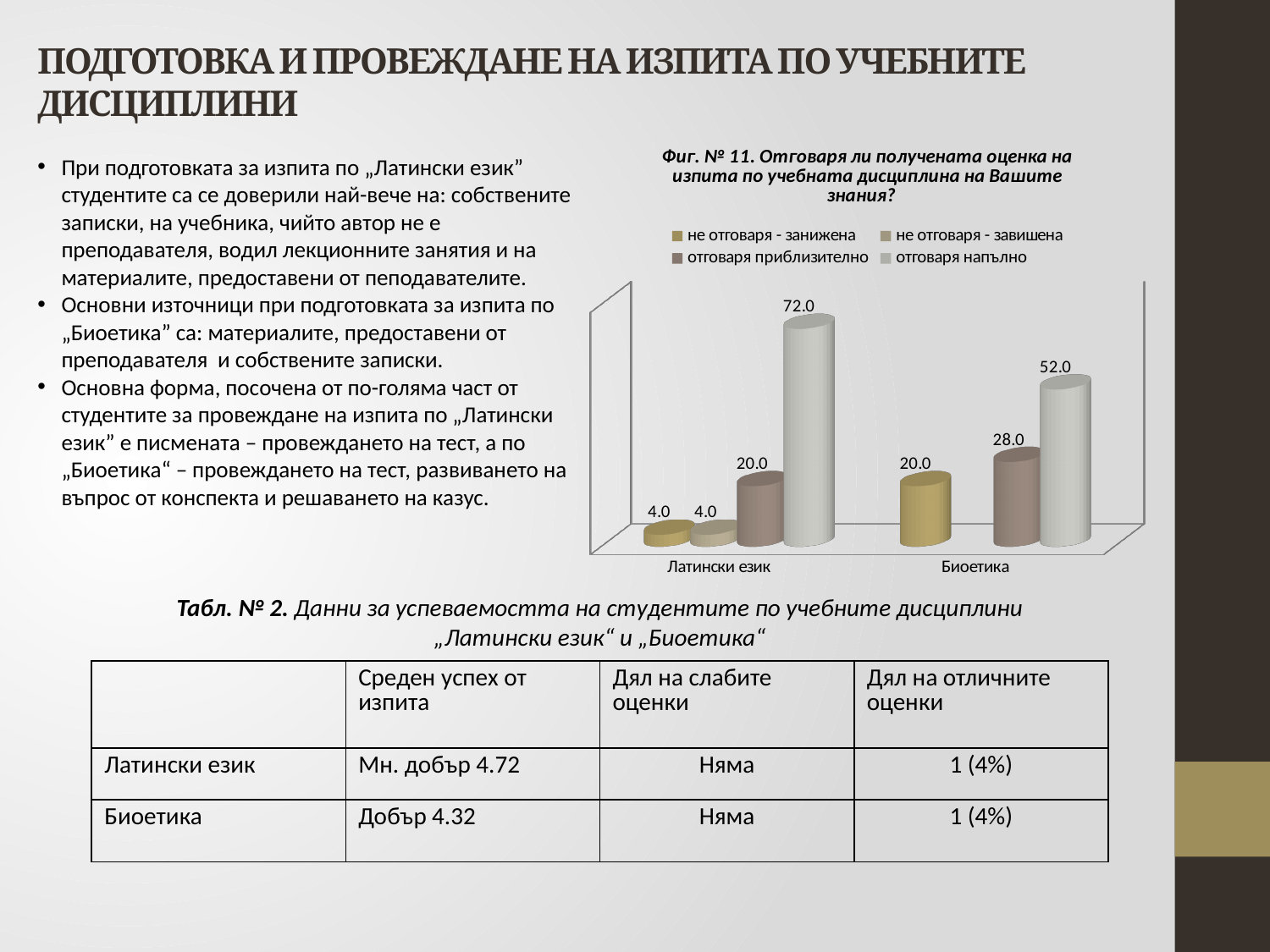
What is the title of the chart on the slide? Фиг. № 11. Отговаря ли получената оценка на изпита по учебната дисциплина на Вашите знания? In Фиг. № 11, what is the value of 'отговаря приблизително' for Латински език? 20.0 In Фиг. № 11, what is the value of 'отговаря напълно' for Биоетика? 52.0 What kind of chart is shown in Фиг. № 11? bar chart In Фиг. № 11, what is the value of 'не отговаря - занижена' for Латински език? 4.0 In Фиг. № 11, what is the value of 'отговаря напълно' for Латински език? 72.0 In Фиг. № 11, which is larger: 'отговаря приблизително' for Латински език or for Биоетика? Биоетика In Фиг. № 11, which series has the highest value for Латински език? отговаря напълно In Фиг. № 11, what is the difference between 'отговаря напълно' for Латински език and for Биоетика? 20.0 How many series does the legend of Фиг. № 11 list? 4 In Фиг. № 11, what is the value of 'отговаря приблизително' for Биоетика? 28.0 How many categories are shown on the x axis of Фиг. № 11? 2